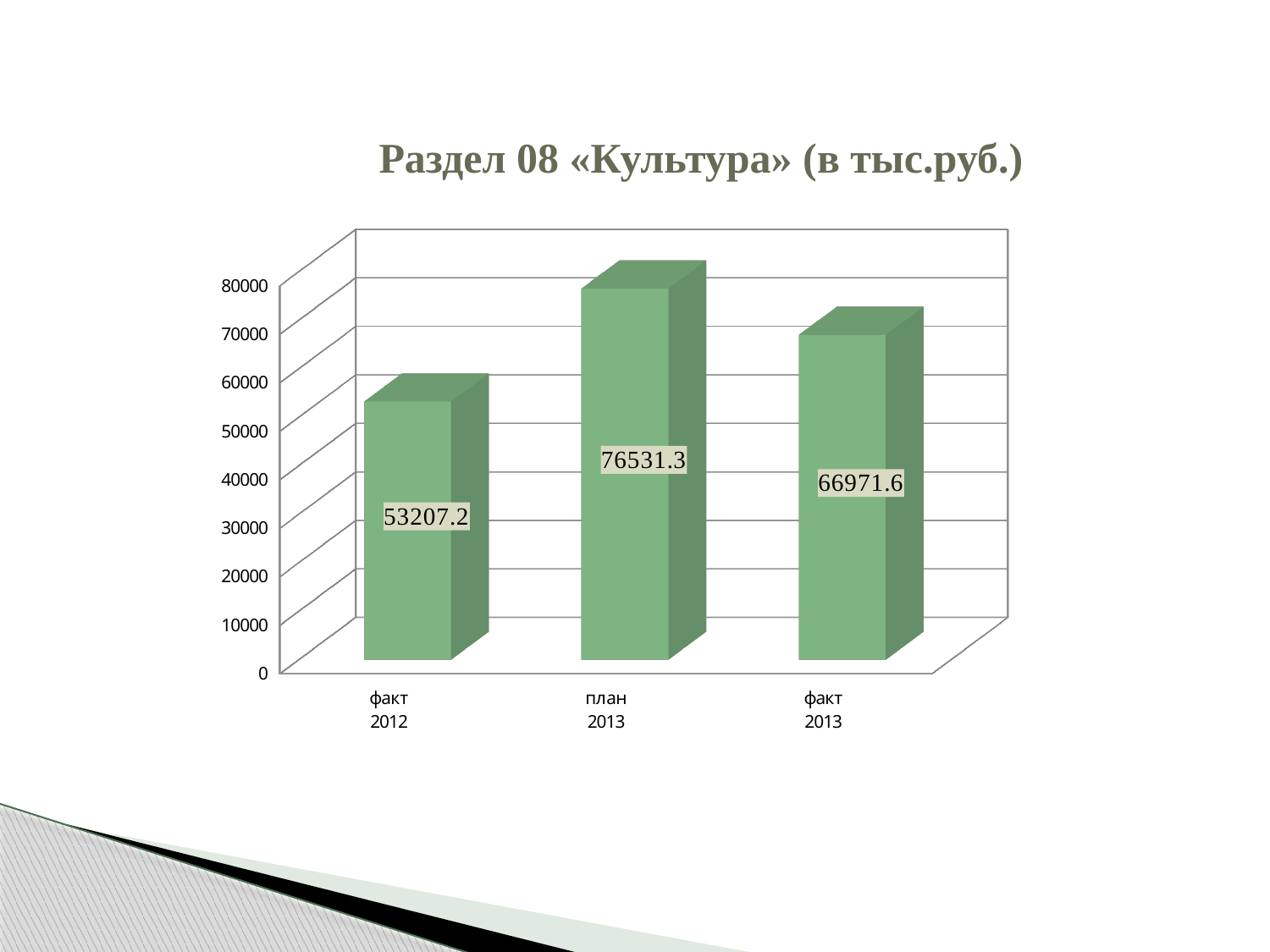
What is the value for факт 2013? 66971.6 What is the value for план 2013? 76531.3 What is the difference between факт 2013 and факт 2012? 13764.4 What is the value for факт 2012? 53207.2 What kind of chart is shown on the slide? bar chart Which category has the highest value? план 2013 What is the title of the chart? Раздел 08 «Культура» (в тыс.руб.) Is the value for план 2013 greater or less than 70000? greater Which is larger, факт 2012 or факт 2013? факт 2013 How many bars are shown in the chart? 3 Which category has the lowest value? факт 2012 What is the difference between план 2013 and факт 2013? 9559.7